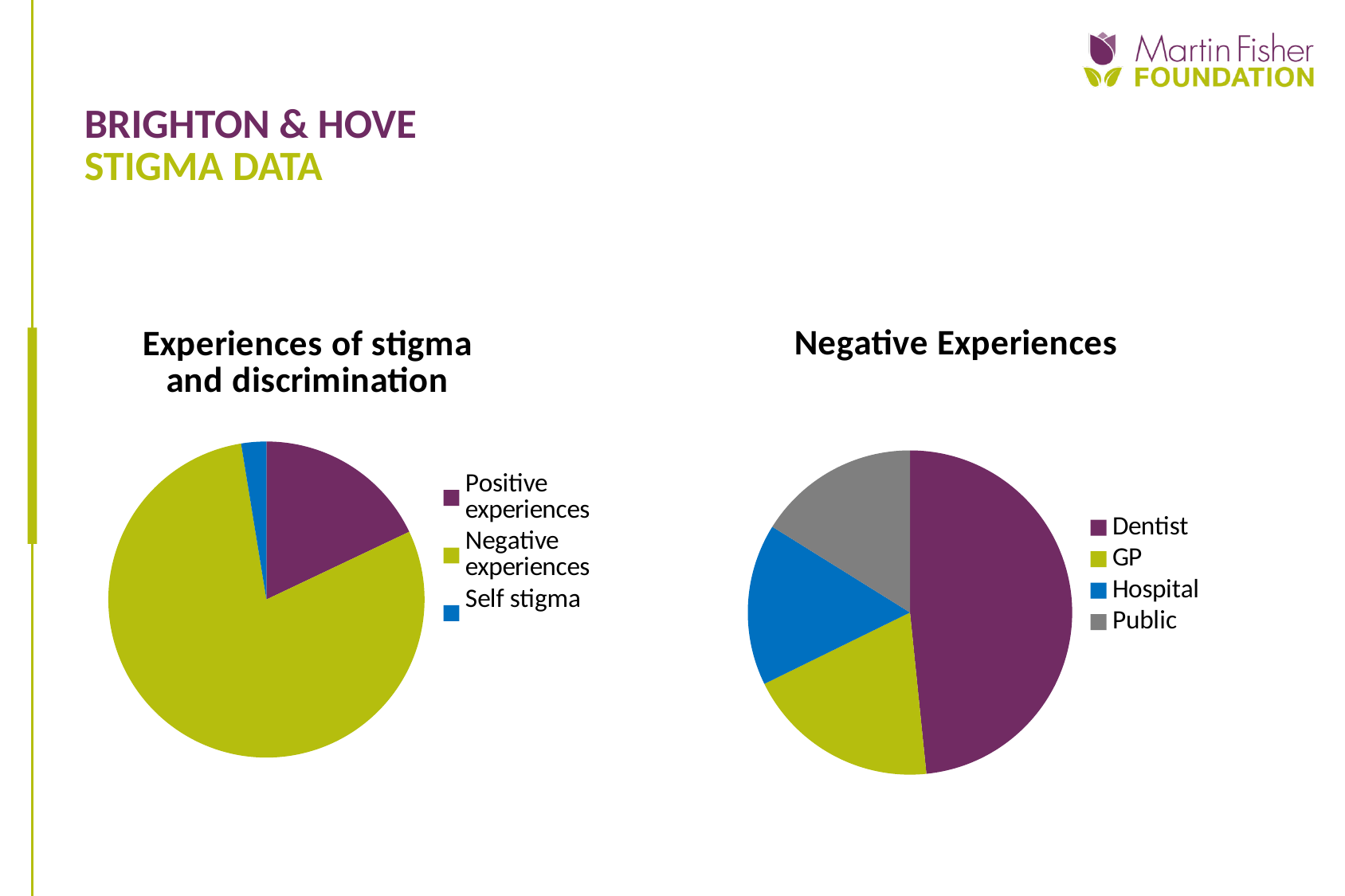
In the 'Experiences of stigma and discrimination' chart, how many slices does the pie have? 3 In the 'Experiences of stigma and discrimination' chart, which category has the largest slice? Negative experiences In the 'Negative Experiences' chart, which slice is larger, Dentist or Public? Dentist In the 'Negative Experiences' chart, what colour is the Hospital slice? Blue In the 'Negative Experiences' chart, which slice is larger, Dentist or GP? Dentist In the 'Negative Experiences' chart, how many categories does the legend list? 4 What is the title of the chart on the right of the slide? Negative Experiences In the 'Experiences of stigma and discrimination' chart, which category has the smallest slice? Self stigma In the 'Experiences of stigma and discrimination' chart, which slice is larger, Positive experiences or Self stigma? Positive experiences In the 'Negative Experiences' chart, which category has the largest slice? Dentist What kind of chart is the 'Experiences of stigma and discrimination' chart? Pie chart What kind of chart is the 'Negative Experiences' chart? Pie chart